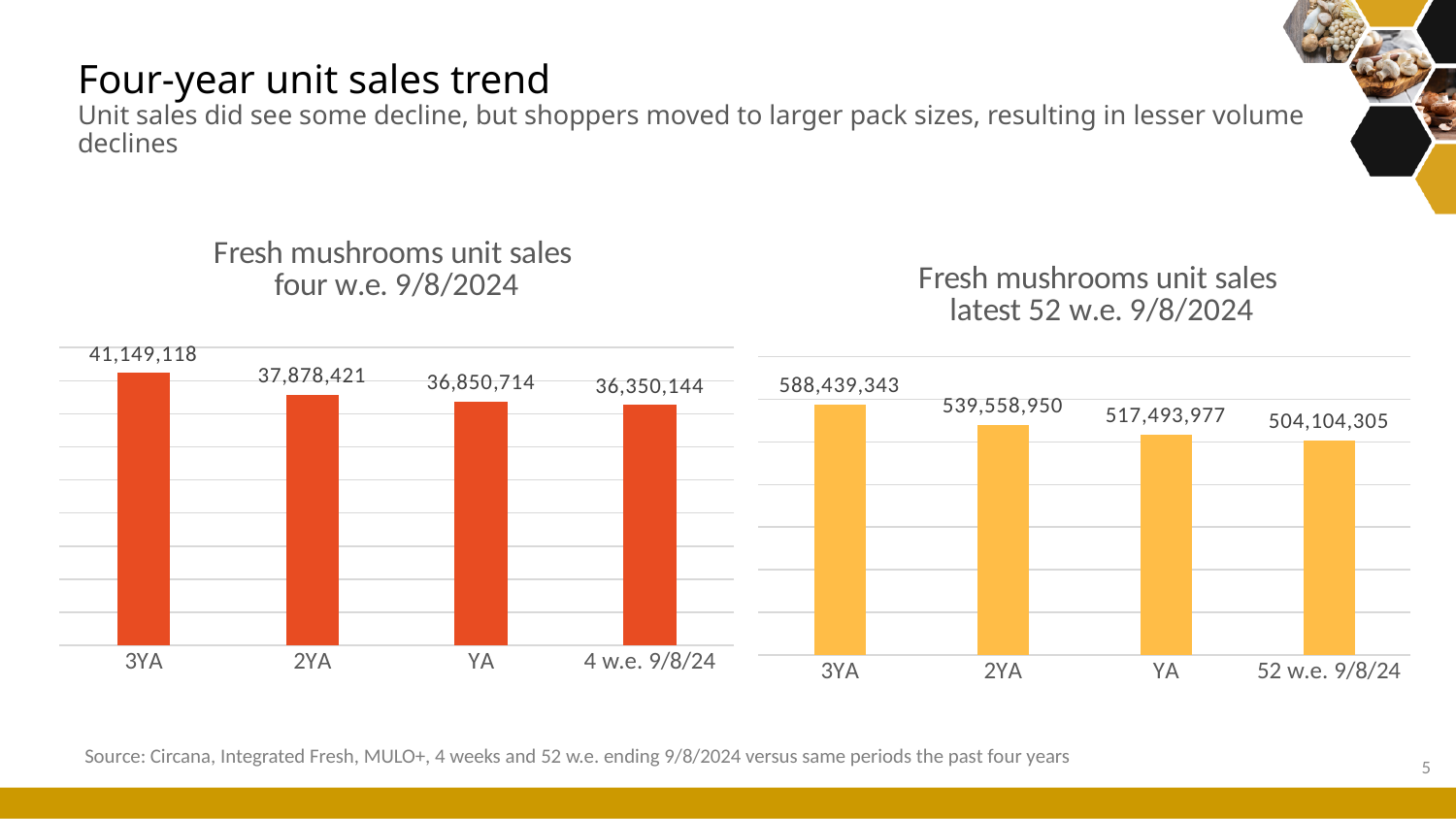
In the 'Fresh mushrooms unit sales latest 52 w.e. 9/8/2024' chart, which is larger, the value for YA or the value for 52 w.e. 9/8/24? YA In the 'Fresh mushrooms unit sales latest 52 w.e. 9/8/2024' chart, what is the difference between the 2YA value and the YA value? 22,064,973 In the 'Fresh mushrooms unit sales latest 52 w.e. 9/8/2024' chart, what is the value for 2YA? 539,558,950 How many bars are in the 'Fresh mushrooms unit sales four w.e. 9/8/2024' chart? 4 In the 'Fresh mushrooms unit sales four w.e. 9/8/2024' chart, which period has the highest unit sales? 3YA In the 'Fresh mushrooms unit sales latest 52 w.e. 9/8/2024' chart, what is the value for 52 w.e. 9/8/24? 504,104,305 In the 'Fresh mushrooms unit sales four w.e. 9/8/2024' chart, what is the difference between the 3YA value and the 4 w.e. 9/8/24 value? 4,798,974 In the 'Fresh mushrooms unit sales latest 52 w.e. 9/8/2024' chart, which period has the lowest unit sales? 52 w.e. 9/8/24 In the 'Fresh mushrooms unit sales latest 52 w.e. 9/8/2024' chart, do the values rise or fall from 3YA to 52 w.e. 9/8/24? Fall In the 'Fresh mushrooms unit sales four w.e. 9/8/2024' chart, what is the value for 4 w.e. 9/8/24? 36,350,144 In the 'Fresh mushrooms unit sales four w.e. 9/8/2024' chart, what is the value for 3YA? 41,149,118 What type of chart is the 'Fresh mushrooms unit sales latest 52 w.e. 9/8/2024' chart? Bar chart